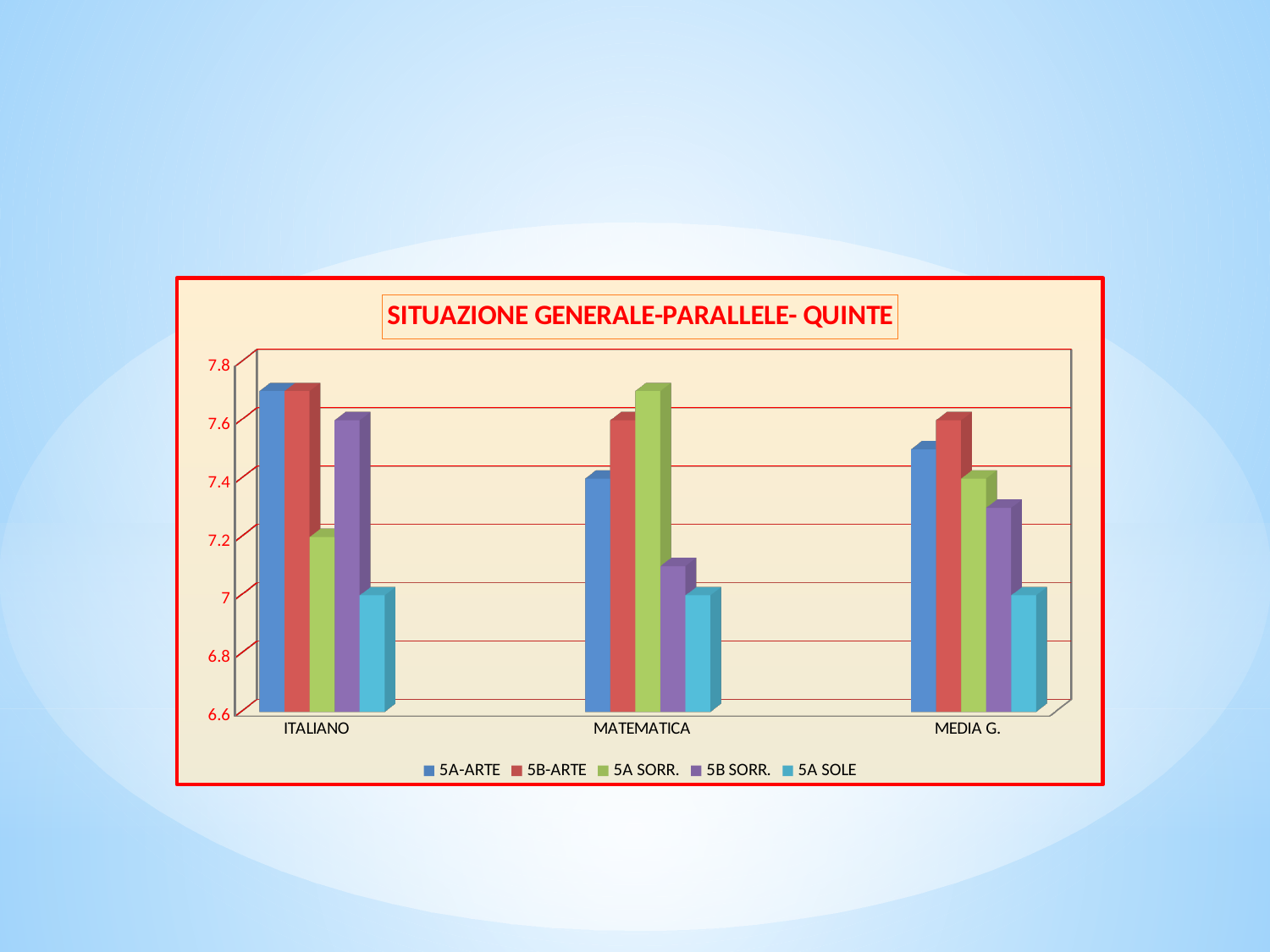
What is the title of the chart? SITUAZIONE GENERALE-PARALLELE- QUINTE Which series is shown in green in the legend? 5A SORR. Which series has the highest value in the MATEMATICA category? 5A SORR. How many categories are shown on the x axis? 3 Is the value for 5B-ARTE in MEDIA G. greater or less than 7.4? greater What kind of chart is shown on the slide? bar chart Is the value for 5A SORR. in MATEMATICA greater or less than 7.6? greater How many series does the legend list? 5 Which series has the lowest value in the MEDIA G. category? 5A SOLE Is the value for 5B SORR. in MATEMATICA greater or less than 7.2? less In the ITALIANO category, which is larger: the value for 5B SORR. or the value for 5A SORR.? 5B SORR.